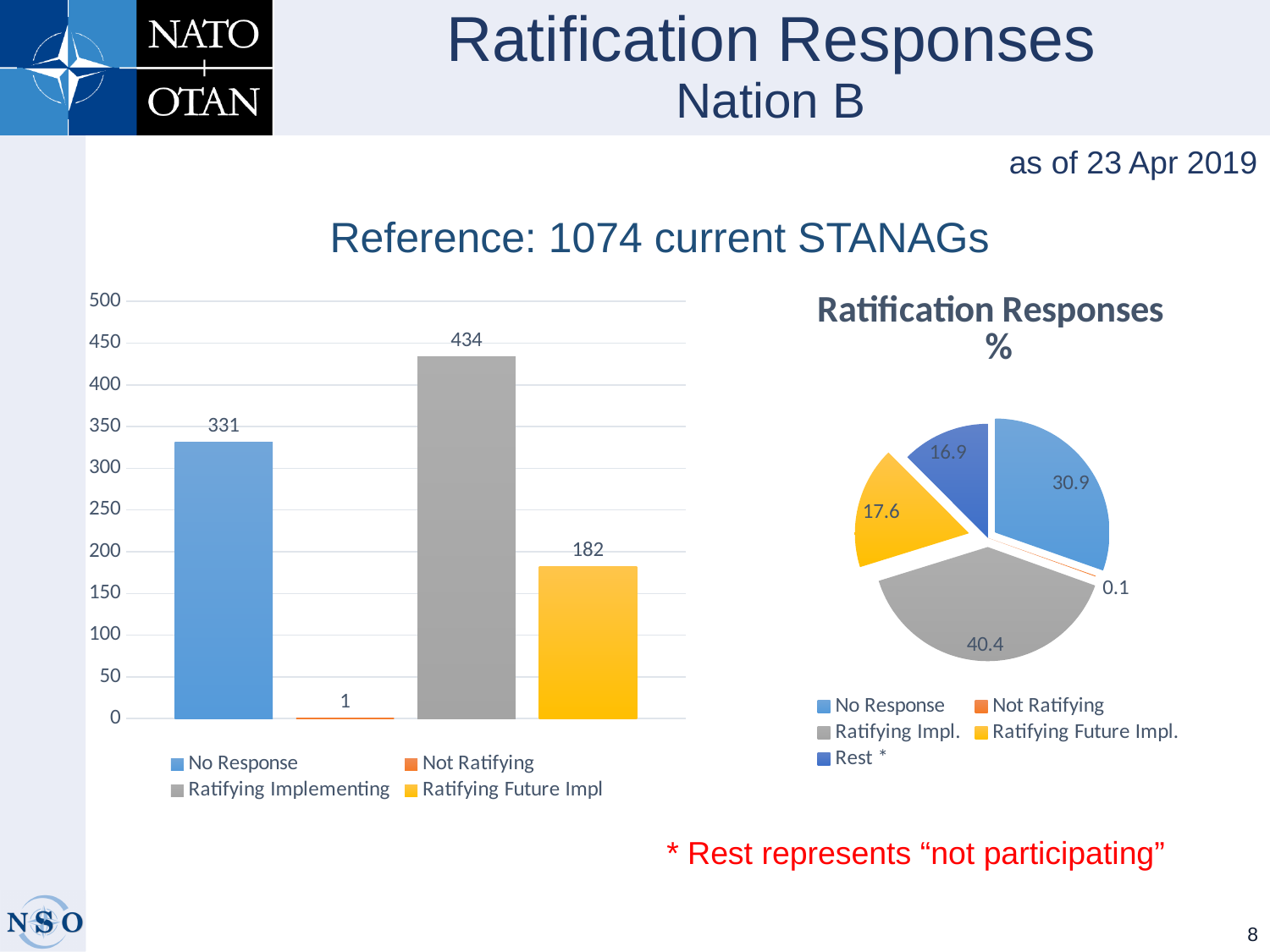
What kind of chart is the chart on the right of the slide? Pie chart In the bar chart on the left, what is the difference between Ratifying Implementing and No Response? 103 In the bar chart on the left, what is the value for No Response? 331 In the bar chart on the left, which category has the lowest value? Not Ratifying In the bar chart on the left, how many series does the legend list? 4 In the bar chart on the left, which is larger: No Response or Ratifying Future Impl? No Response In the pie chart titled 'Ratification Responses %', what is the value for Rest *? 16.9 In the pie chart titled 'Ratification Responses %', which slice is the smallest? Not Ratifying In the bar chart on the left, what is the value for Not Ratifying? 1 In the bar chart on the left, what is the value for Ratifying Implementing? 434 In the bar chart on the left, which category has the highest value? Ratifying Implementing In the pie chart titled 'Ratification Responses %', what is the value for Ratifying Impl.? 40.4